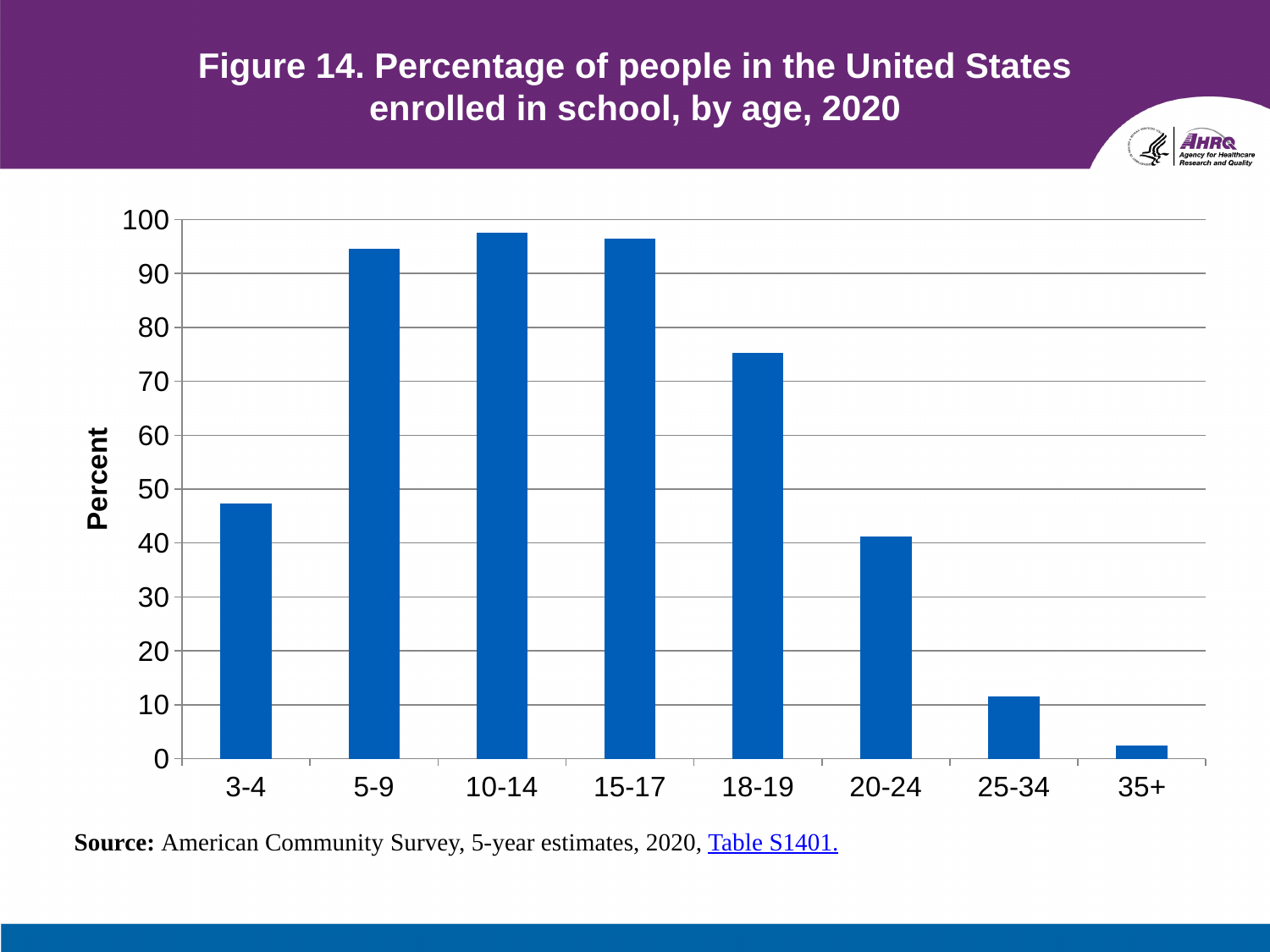
Is the value for the 18-19 age group greater or less than 70? greater What is the label on the y axis? Percent Which has a higher percentage enrolled in school, the 18-19 age group or the 20-24 age group? 18-19 Is the value for the 5-9 age group greater or less than 90? greater From the 15-17 age group onward, do the values rise or fall as age increases? fall Is the value for the 3-4 age group greater or less than 50? less Which has a higher percentage enrolled in school, the 3-4 age group or the 25-34 age group? 3-4 What kind of chart is shown on the slide? bar chart How many age groups are shown on the x axis? 8 Which age group has the lowest percentage enrolled in school? 35+